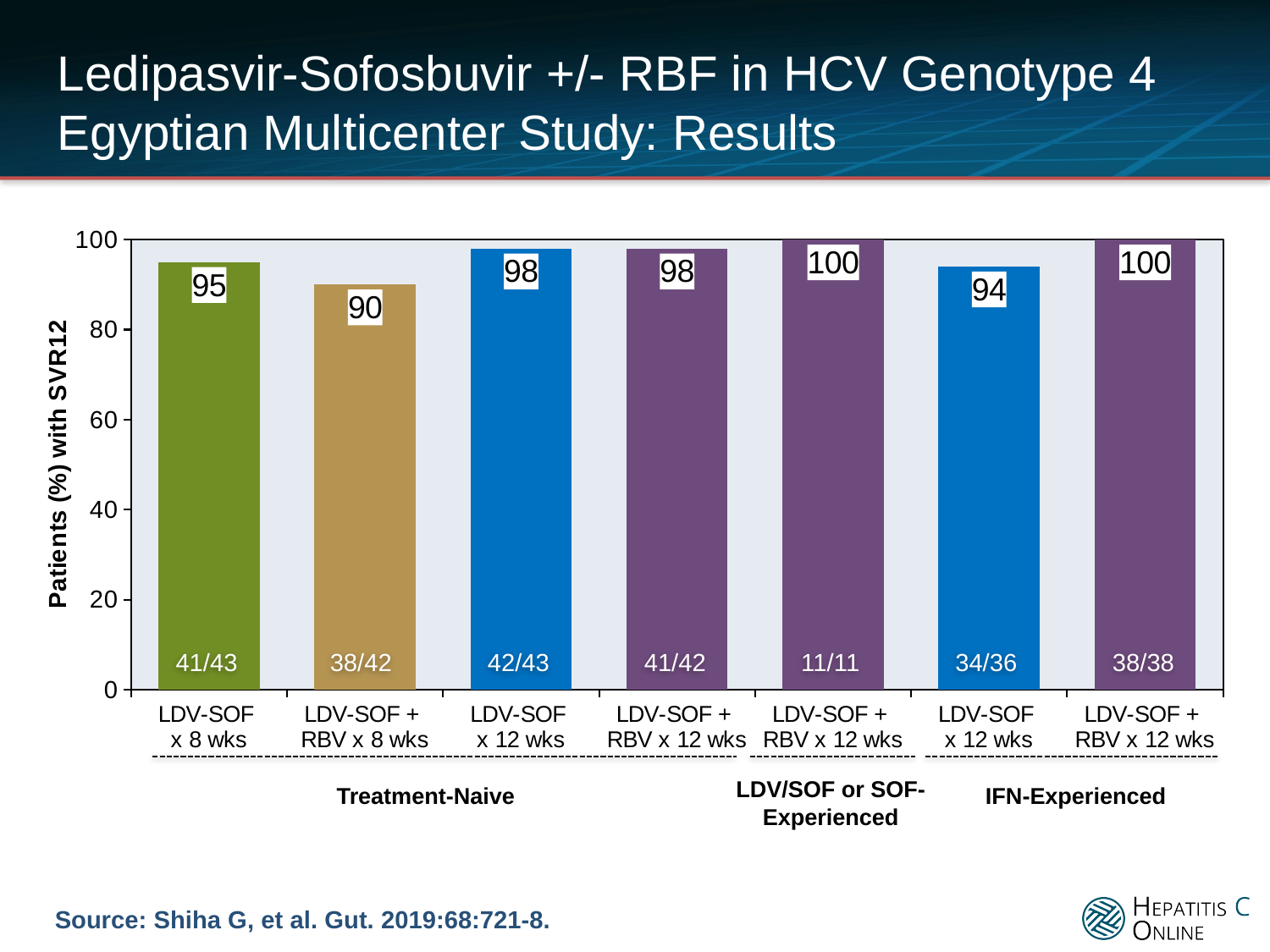
What is the SVR12 percentage for LDV-SOF + RBV x 12 wks in the LDV/SOF or SOF-Experienced group? 100 What is the difference in SVR12 percentage between LDV-SOF x 8 wks and LDV-SOF + RBV x 8 wks in the Treatment-Naive group? 5 What is the SVR12 percentage for LDV-SOF + RBV x 8 wks in the Treatment-Naive group? 90 What is the SVR12 percentage for LDV-SOF x 8 wks in the Treatment-Naive group? 95 What type of chart is shown on the slide? bar chart What is the label of the y axis? Patients (%) with SVR12 What is the SVR12 percentage for LDV-SOF x 12 wks in the IFN-Experienced group? 94 Which Treatment-Naive regimen has the lowest SVR12 percentage? LDV-SOF + RBV x 8 wks How many bars are plotted in the chart? 7 In the IFN-Experienced group, which regimen has the higher SVR12 percentage, LDV-SOF x 12 wks or LDV-SOF + RBV x 12 wks? LDV-SOF + RBV x 12 wks What is the difference in SVR12 percentage between LDV-SOF + RBV x 12 wks in the IFN-Experienced group and LDV-SOF x 12 wks in the IFN-Experienced group? 6 What is the patient fraction shown inside the bar for LDV-SOF x 12 wks in the Treatment-Naive group? 42/43